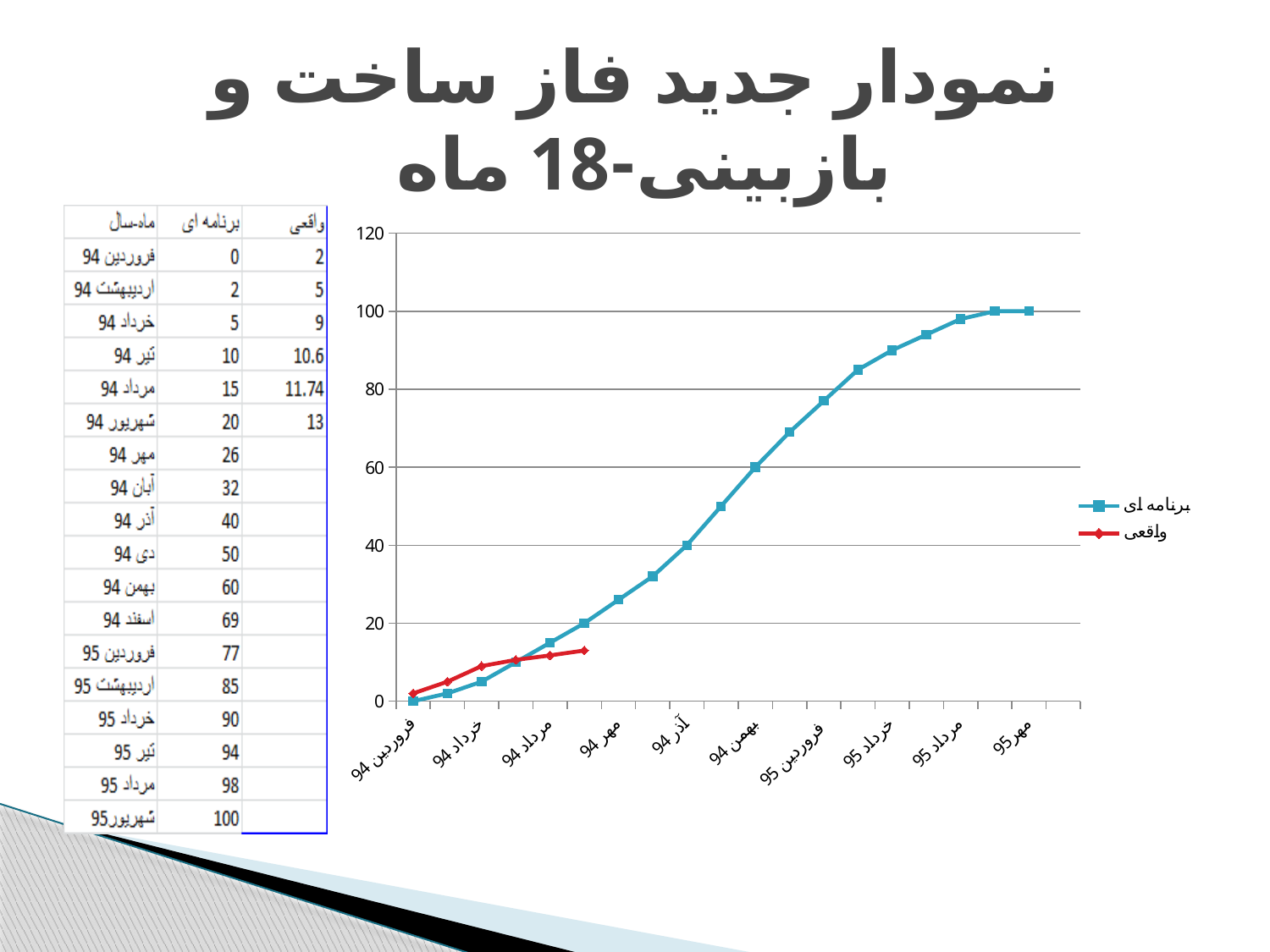
How many series does the chart legend list? 2 What are the two series named in the chart legend? برنامه ای and واقعی What is the difference between the برنامه ای and واقعی values for شهریور 94? 7 Is the واقعی value for شهریور 94 greater or less than 20? less Which series has the larger value at خرداد 94, برنامه ای or واقعی? واقعی What is the واقعی value for مرداد 94? 11.74 What kind of chart is shown on the slide? line chart Does the برنامه ای series rise or fall along the x axis? rise Is the برنامه ای value for فروردین 95 greater or less than 60? greater What is the برنامه ای value for شهریور 95? 100 Which series has the larger value at مرداد 94, برنامه ای or واقعی? برنامه ای What is the برنامه ای value for بهمن 94? 60